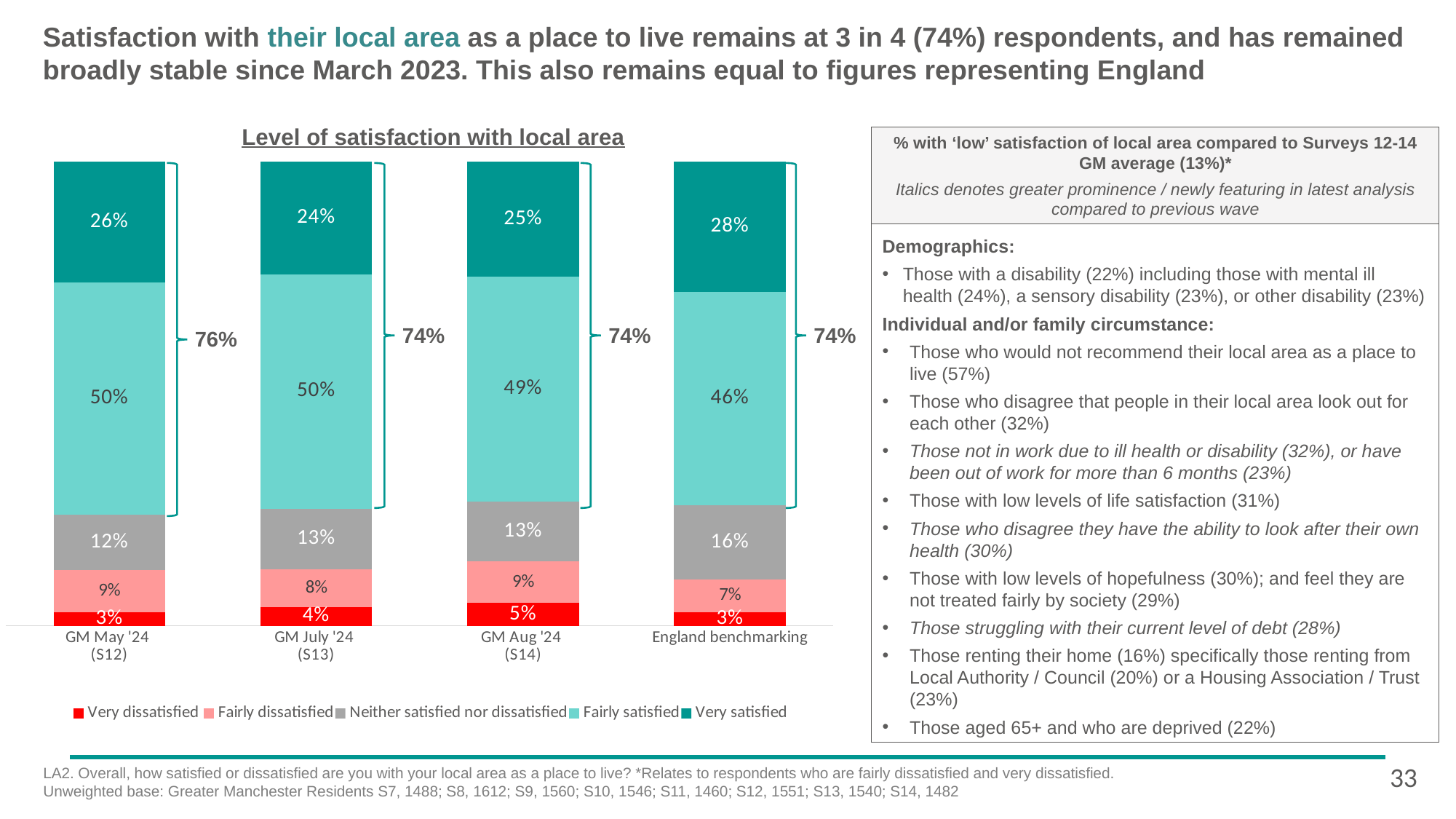
Which bar has the lowest 'Fairly dissatisfied' percentage? England benchmarking How many bars (categories) are shown in the chart? 4 What percentage of respondents were 'Very dissatisfied' in GM Aug '24 (S14)? 5% What type of chart is used to show the level of satisfaction with local area? Stacked bar chart Is the 'Neither satisfied nor dissatisfied' percentage larger in GM Aug '24 (S14) or in England benchmarking? England benchmarking What is the difference between the 'Fairly satisfied' percentage in GM May '24 (S12) and in England benchmarking? 4 percentage points How many series does the legend list? 5 What percentage were 'Neither satisfied nor dissatisfied' in GM July '24 (S13)? 13% What is the combined satisfied (Fairly satisfied plus Very satisfied) percentage shown by the bracket for GM May '24 (S12)? 76% What percentage of respondents were 'Fairly satisfied' in the England benchmarking bar? 46% Which bar has the highest 'Very satisfied' percentage? England benchmarking What percentage of respondents were 'Very satisfied' with their local area in GM May '24 (S12)? 26%